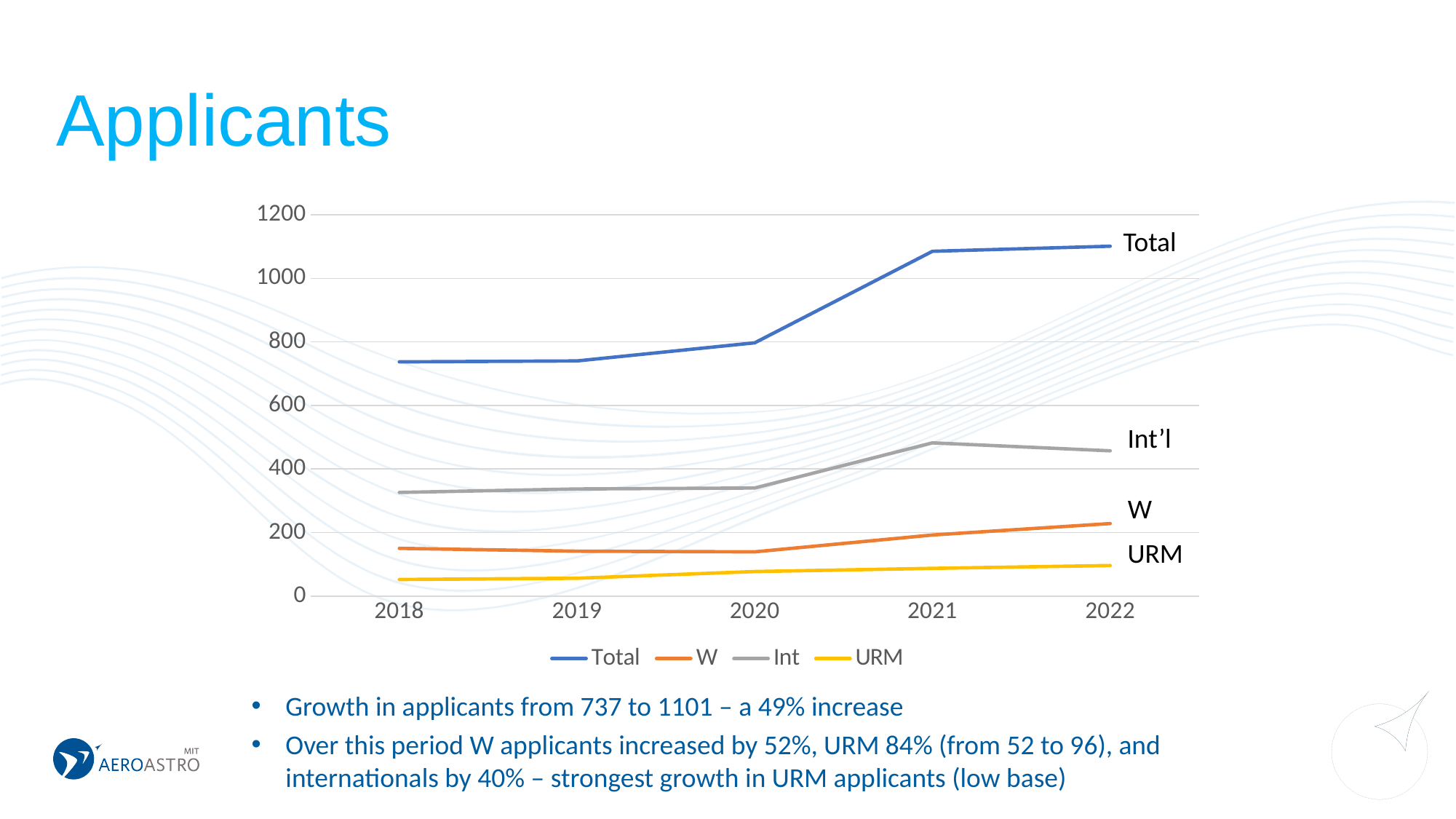
Which series has the lowest values across all years in the chart? URM What is the title of the slide containing the chart? Applicants Which series has the highest values across all years in the chart? Total Is the value for URM in 2020 greater or less than 100? less How many years are shown on the x axis of the chart? 5 Is the value for Total in 2021 greater or less than 1000? greater Does the Total series rise or fall from 2018 to 2022? rise Is the value for Int in 2018 greater or less than 400? less How many series does the chart legend list? 4 Which is larger in 2022, the value for W or the value for URM? W What kind of chart is shown on the slide? line chart